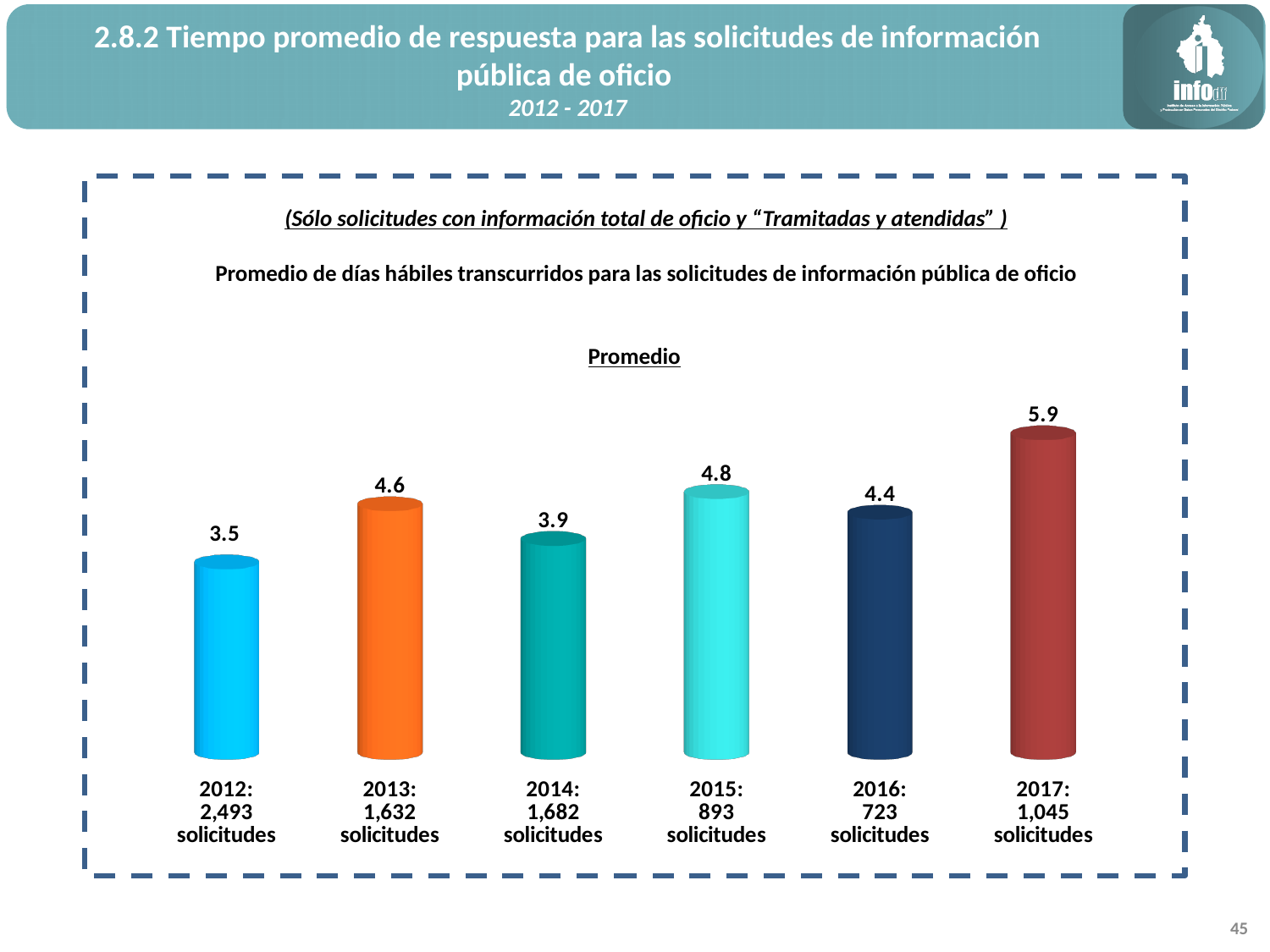
Which year has the highest average value? 2017 Which is larger, the average value for 2013 or for 2016? 2013 How many solicitudes are listed for 2016 in the category label? 723 What is the difference between the average values for 2017 and 2012? 2.4 What kind of chart is shown on the slide? Bar chart How many years (bars) are shown in the chart? 6 Which year has the lowest average value? 2012 What is the title shown directly above the bars? Promedio What is the average value shown for 2015? 4.8 What is the difference between the average values for 2013 and 2014? 0.7 What is the average value shown for 2017? 5.9 What is the average number of business days (Promedio) for 2012? 3.5